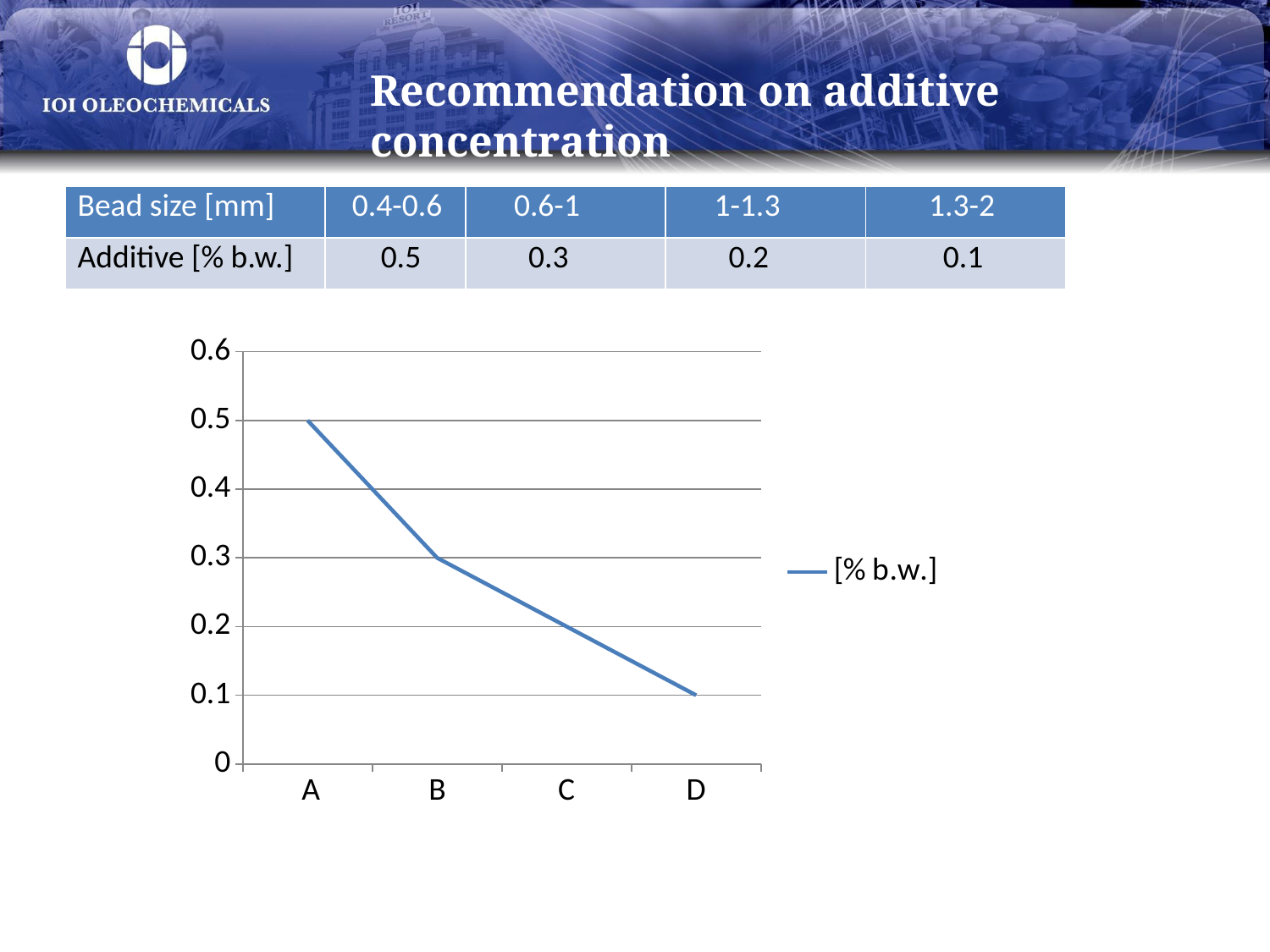
What is the value for A in the line chart? 0.5 What kind of chart is shown on the slide? line chart Which category has the highest value in the line chart? A How many points are plotted on the line chart? 4 What is the legend entry for the series in the line chart? [% b.w.] How many series does the legend of the line chart list? 1 Which category has the lowest value in the line chart? D What is the value for D in the line chart? 0.1 Do the values in the line chart rise or fall from A to D? fall What is the value for B in the line chart? 0.3 Which is larger in the line chart, the value for B or the value for C? B What is the difference between the values for A and B in the line chart? 0.2